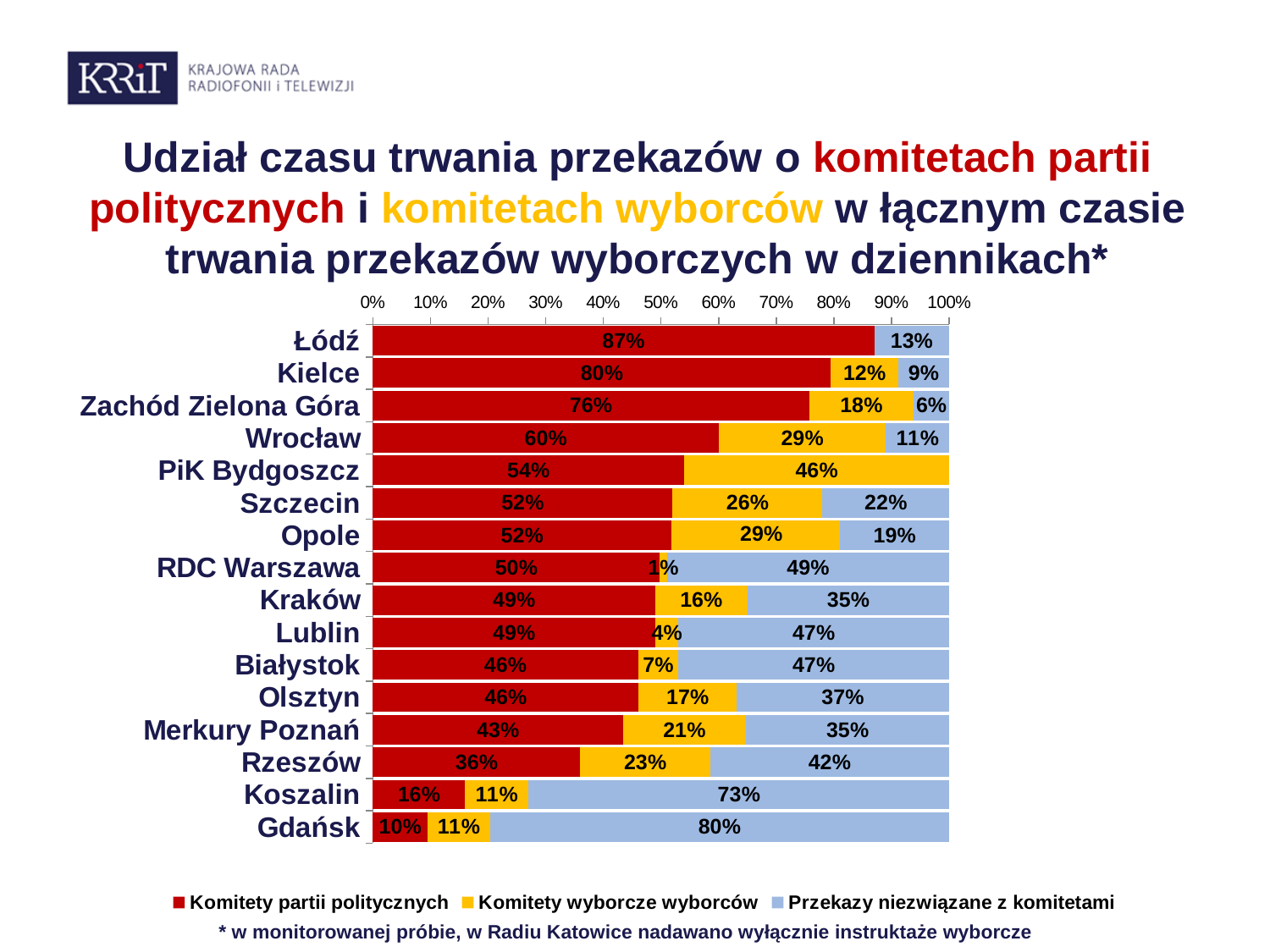
Which station has the lowest value for Komitety partii politycznych? Gdańsk How many radio stations (categories) are shown on the chart? 16 Which station has the highest value for Komitety partii politycznych? Łódź How many series does the legend list? 3 What is the value for Komitety partii politycznych for Łódź? 87% Which is larger: the Komitety wyborcze wyborców value for Wrocław or for Kraków? Wrocław Which colour represents Komitety wyborcze wyborców in the chart? yellow What is the value for Komitety wyborcze wyborców for PiK Bydgoszcz? 46% Which station has the highest value for Przekazy niezwiązane z komitetami? Gdańsk What is the value for Przekazy niezwiązane z komitetami for Gdańsk? 80% What type of chart is shown on the slide? stacked bar chart What is the difference between the Komitety partii politycznych values for Kielce and Rzeszów? 44%